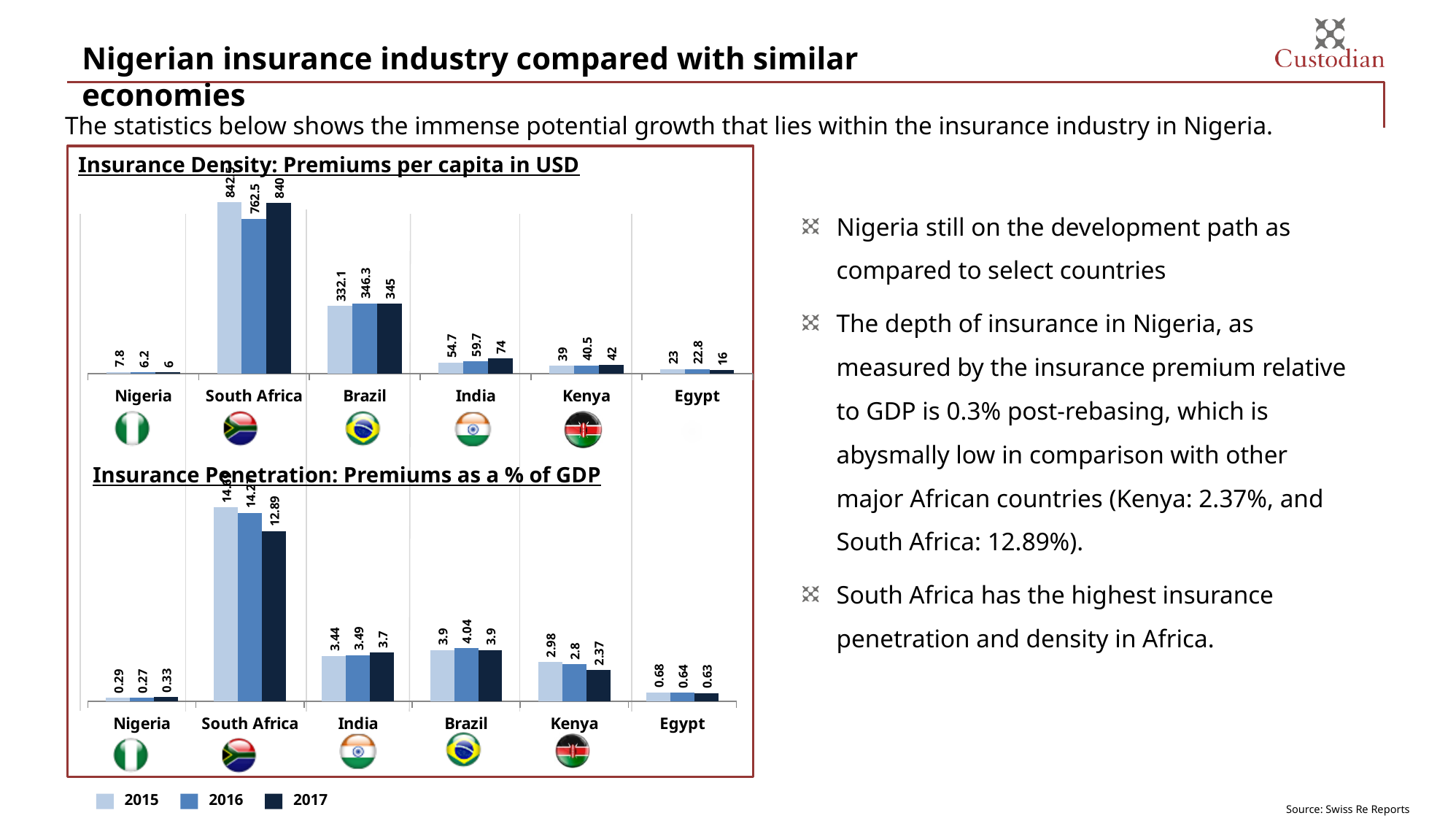
In the Insurance Penetration chart, what is the 2017 value for South Africa? 12.89 In the Insurance Density chart, which is larger: Kenya's 2017 value or Egypt's 2017 value? Kenya's 2017 value In the Insurance Density chart, what is the 2015 value for Nigeria? 7.8 How many series does the legend list for the charts? 3 In the Insurance Density chart, what is the 2017 value for South Africa? 840 In the Insurance Penetration chart, what is the difference between Kenya's 2015 and 2017 values? 0.61 In the Insurance Density chart, which country has the lowest 2017 value? Nigeria How many countries are shown in the Insurance Penetration chart? 6 In the Insurance Penetration chart, what is the 2016 value for Brazil? 4.04 In the Insurance Density chart, what is the difference between India's 2017 and 2015 values? 19.3 In the Insurance Density chart, what is the 2016 value for Brazil? 346.3 In the Insurance Penetration chart, which country has the highest 2017 value? South Africa